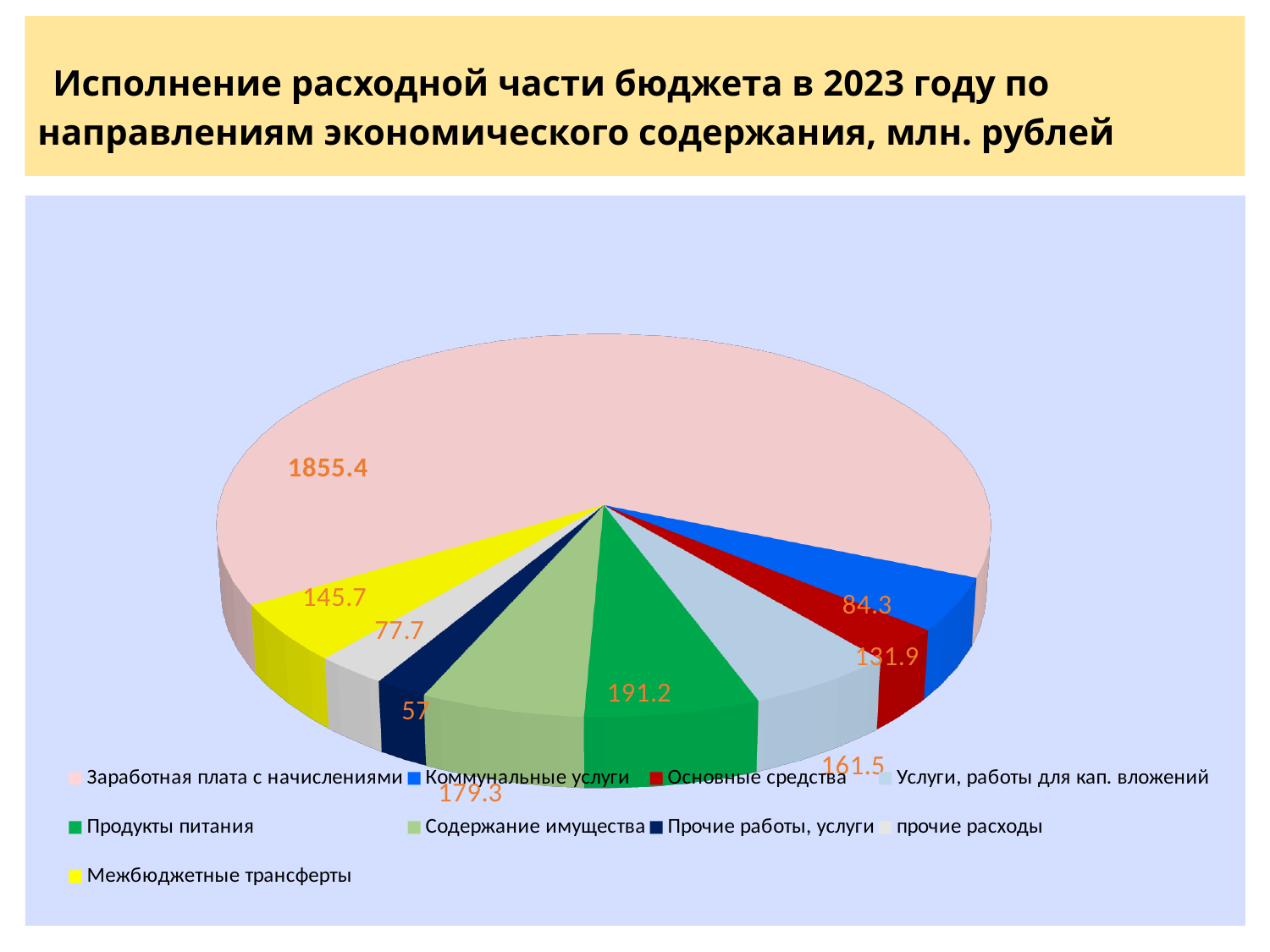
What is the value for Продукты питания? 191.2 Which category has the largest slice of the pie? Заработная плата с начислениями Which category has the smallest slice of the pie? Прочие работы, услуги What is the difference between the values for Основные средства and Коммунальные услуги? 47.6 What type of chart is shown on the slide? Pie chart What is the value for Заработная плата с начислениями? 1855.4 What is the value for Коммунальные услуги? 131.9 How many categories does the pie chart have? 9 What is the value for Межбюджетные трансферты? 145.7 What is the value for Прочие работы, услуги? 57 Which is larger: Содержание имущества or Услуги, работы для кап. вложений? Содержание имущества What unit of measurement is stated in the chart title? млн. рублей